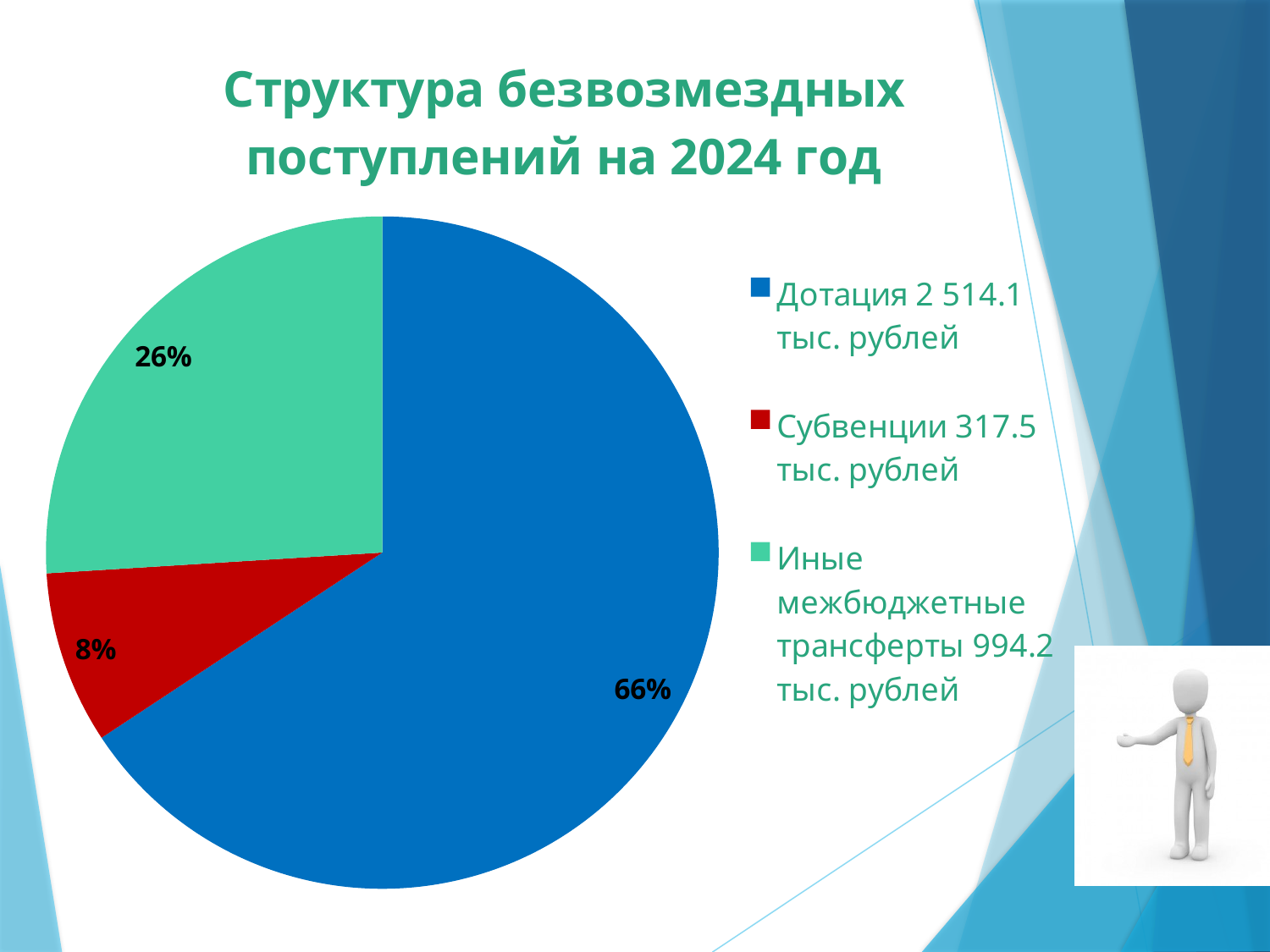
What kind of chart is shown on the slide? pie chart What share of the pie does Дотация account for? 66% What share of the pie does Иные межбюджетные трансферты account for? 26% Which category has the largest slice of the pie? Дотация Which is larger, the Субвенции slice or the Иные межбюджетные трансферты slice? Иные межбюджетные трансферты How many slices does the pie chart have? 3 Which category has the smallest slice of the pie? Субвенции What share of the pie does Субвенции account for? 8% What is the difference in percentage points between the Дотация slice and the Иные межбюджетные трансферты slice? 40 According to the legend, what amount in тыс. рублей is given for Субвенции? 317.5 What is the title of the chart on the slide? Структура безвозмездных поступлений на 2024 год What is the difference in percentage points between the Иные межбюджетные трансферты slice and the Субвенции slice? 18